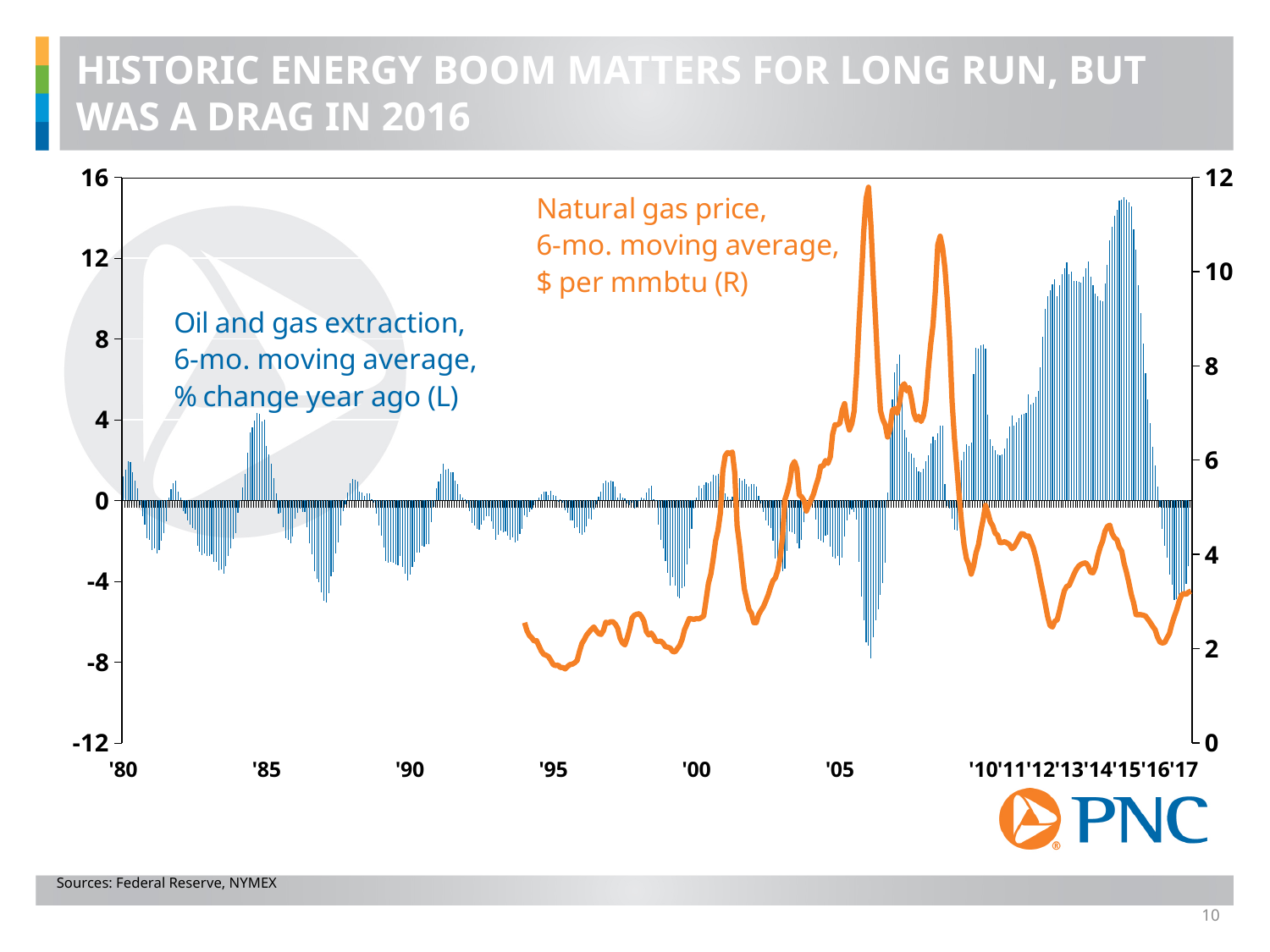
Is the natural gas price at the end of the series in 2017 greater or less than 4 on the right axis? less Is the lowest oil and gas extraction bar around 2006 greater or less than -4 on the left axis? less Is the natural gas price around 2012 greater or less than 4 on the right axis? less Do the oil and gas extraction bars rise or fall from 2015 to 2016? Fall What kind of chart is shown on the slide? A combination bar and line chart How many data series are plotted on the chart? 2 Which axis (left or right) does the oil and gas extraction series use? Left Does the natural gas price line rise or fall between 2014 and 2016? Fall Which series is plotted as the orange line? Natural gas price, 6-mo. moving average, $ per mmbtu